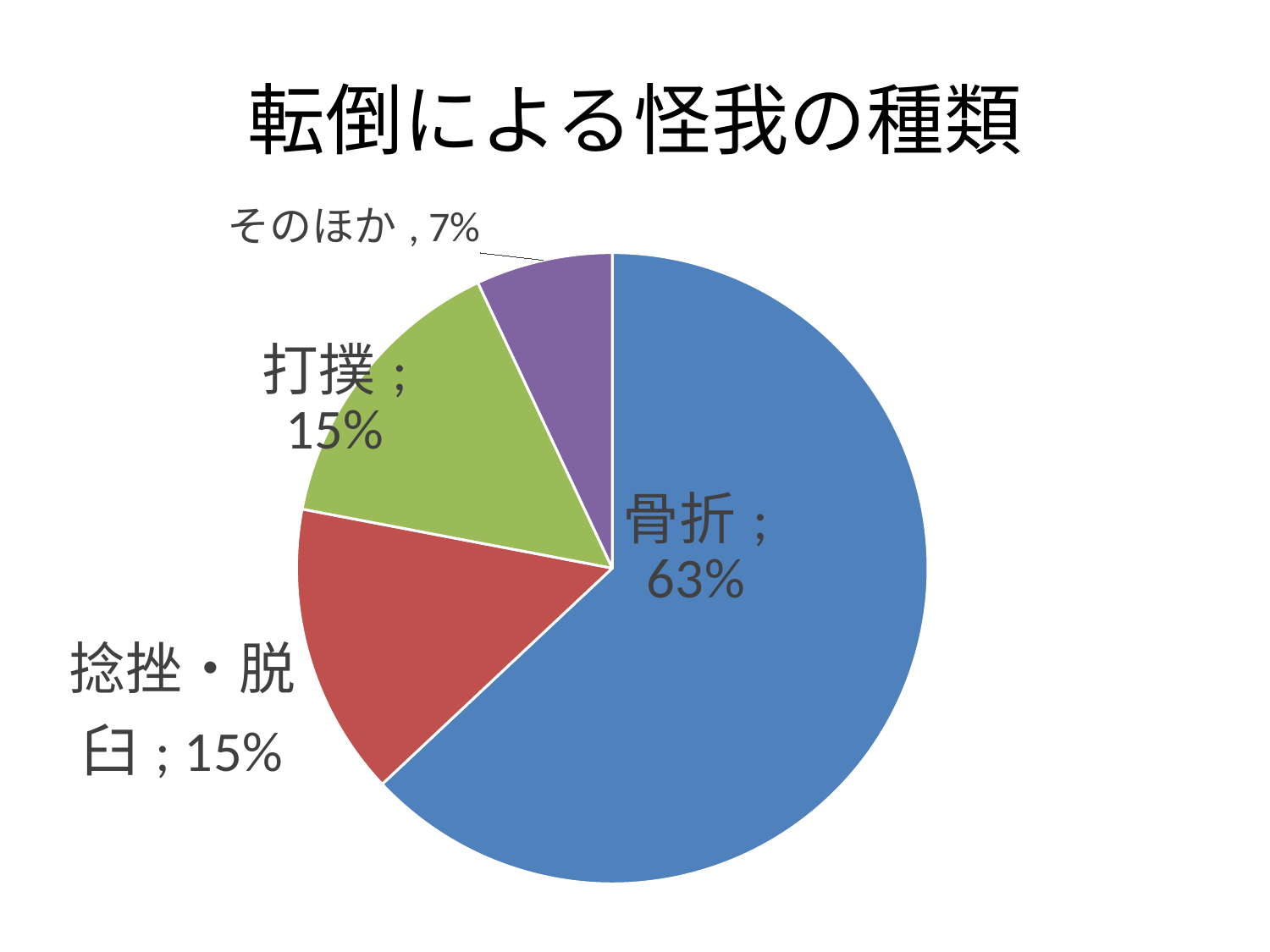
Which category has the smallest slice of the pie? そのほか What share of the pie does 捻挫・脱臼 represent? 15% What is the title of the chart? 転倒による怪我の種類 What share of the pie does 打撲 represent? 15% Which is larger, the slice for 骨折 or the slice for そのほか? 骨折 What share of the pie does そのほか represent? 7% What colour is the slice for 骨折? blue Which category has the largest slice of the pie? 骨折 What kind of chart is shown on the slide? pie chart What is the difference in percentage points between 骨折 and 打撲? 48 How many categories are shown in the pie chart? 4